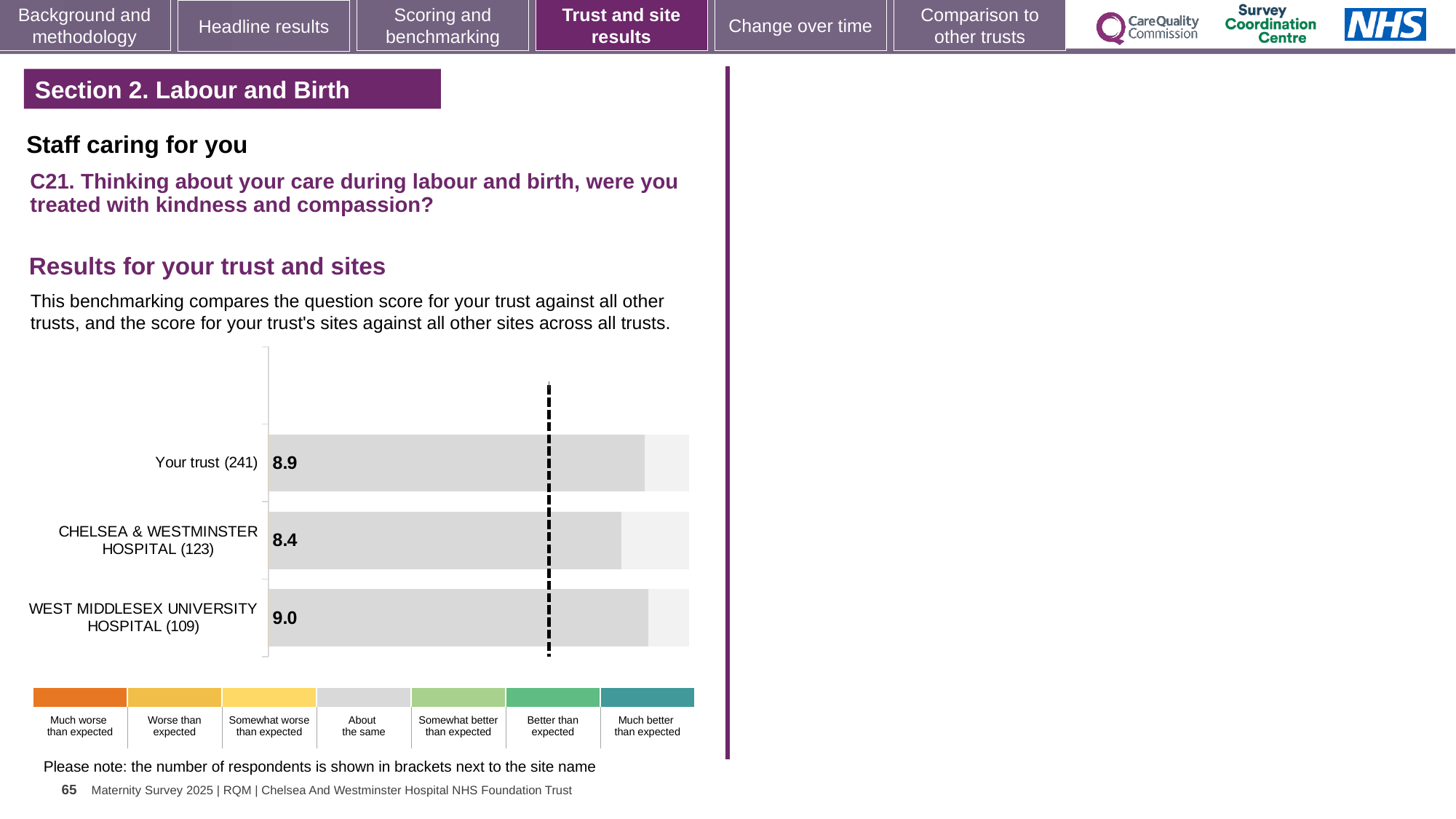
Which bar has the lowest score? CHELSEA & WESTMINSTER HOSPITAL (123) How many respondents are shown in brackets for WEST MIDDLESEX UNIVERSITY HOSPITAL? 109 What is the score for WEST MIDDLESEX UNIVERSITY HOSPITAL (109)? 9.0 What kind of chart is shown on the slide? Bar chart What is the score for CHELSEA & WESTMINSTER HOSPITAL (123)? 8.4 Which bar has the highest score? WEST MIDDLESEX UNIVERSITY HOSPITAL (109) How many bars are shown in the chart? 3 Which category in the colour key below the chart is shown in grey? About the same What is the score for Your trust (241)? 8.9 What is the difference between the scores for Your trust (241) and CHELSEA & WESTMINSTER HOSPITAL (123)? 0.5 What is the difference between the scores for WEST MIDDLESEX UNIVERSITY HOSPITAL (109) and CHELSEA & WESTMINSTER HOSPITAL (123)? 0.6 Which has a higher score, Your trust (241) or CHELSEA & WESTMINSTER HOSPITAL (123)? Your trust (241)